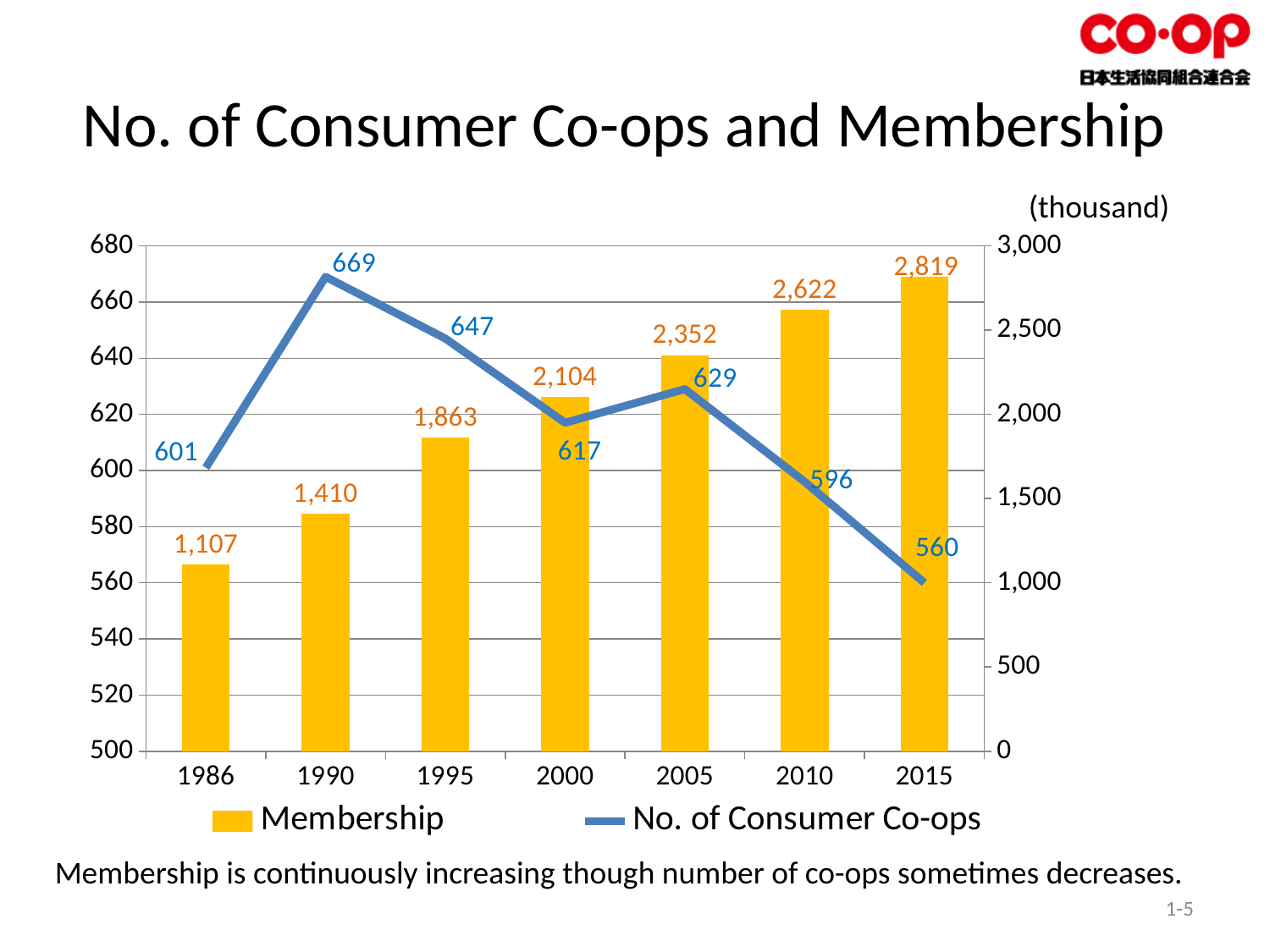
What is the No. of Consumer Co-ops value for 1990? 669 Which is larger, the No. of Consumer Co-ops in 2000 or in 2005? 2005 How many years are shown on the x axis? 7 Does Membership rise or fall from 1986 to 2015? rise What is the difference in No. of Consumer Co-ops between 1990 and 2015? 109 What is the Membership value for 2015? 2,819 How many series does the legend list? 2 In which year is the No. of Consumer Co-ops highest? 1990 In which year is the No. of Consumer Co-ops lowest? 2015 What is the Membership value for 1986? 1,107 In which year is Membership lowest? 1986 What is the difference in Membership between 2015 and 2010? 197